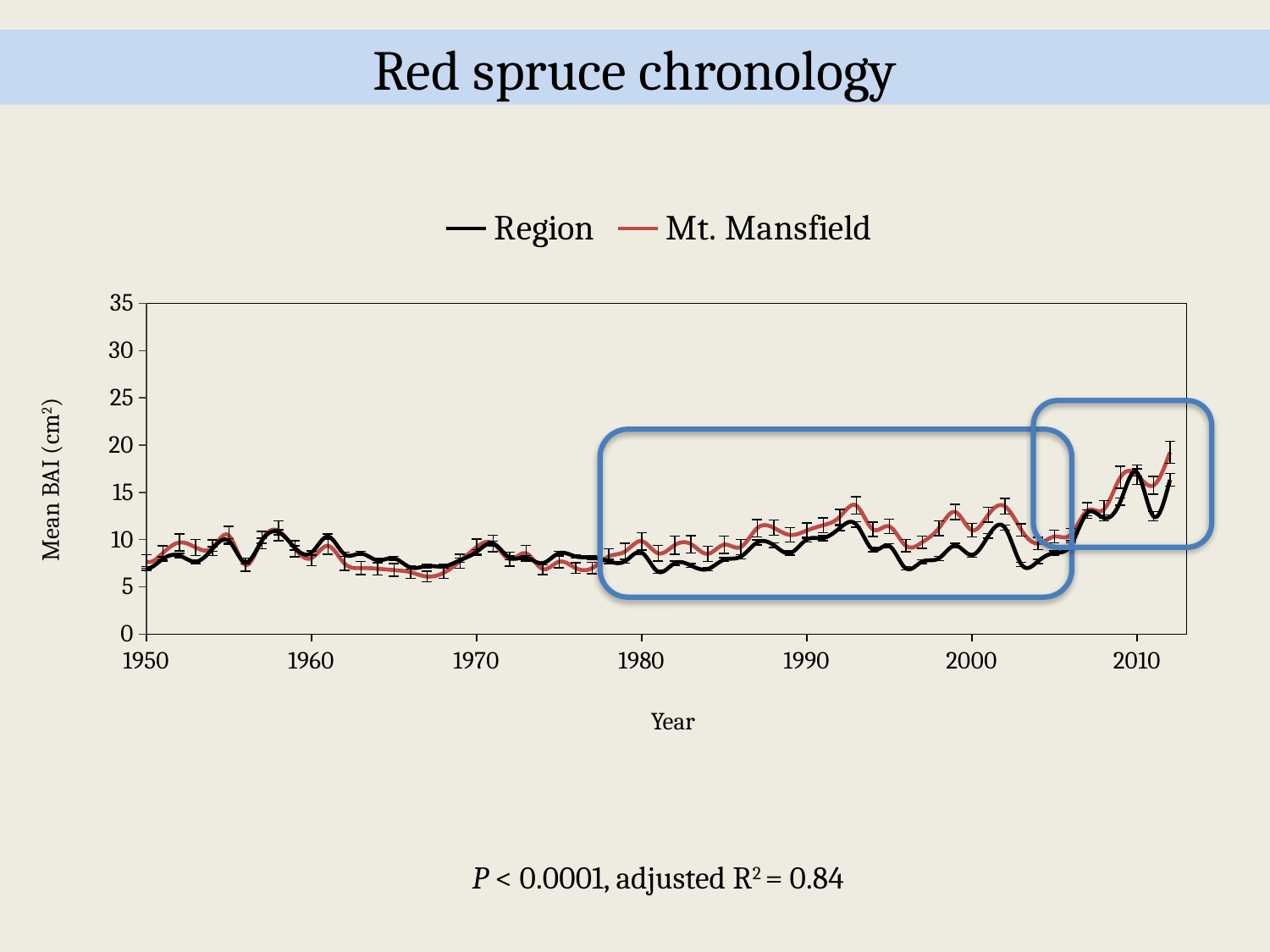
Is the Mt. Mansfield value in 1967 greater or less than 10? less How many series does the legend list? 2 In 2000, which series has the larger value, Region or Mt. Mansfield? Mt. Mansfield What is the title of the chart on the slide? Red spruce chronology What kind of chart is shown on the slide? line chart In 2012, which series has the larger value, Region or Mt. Mansfield? Mt. Mansfield Which series reaches the highest value anywhere on the chart? Mt. Mansfield Between 2005 and 2010, do the Region values generally rise or fall? rise What is the label of the y axis? Mean BAI (cm²) Is the Region value in 2010 greater or less than 15? greater Is the Mt. Mansfield value in 2012 greater or less than 15? greater